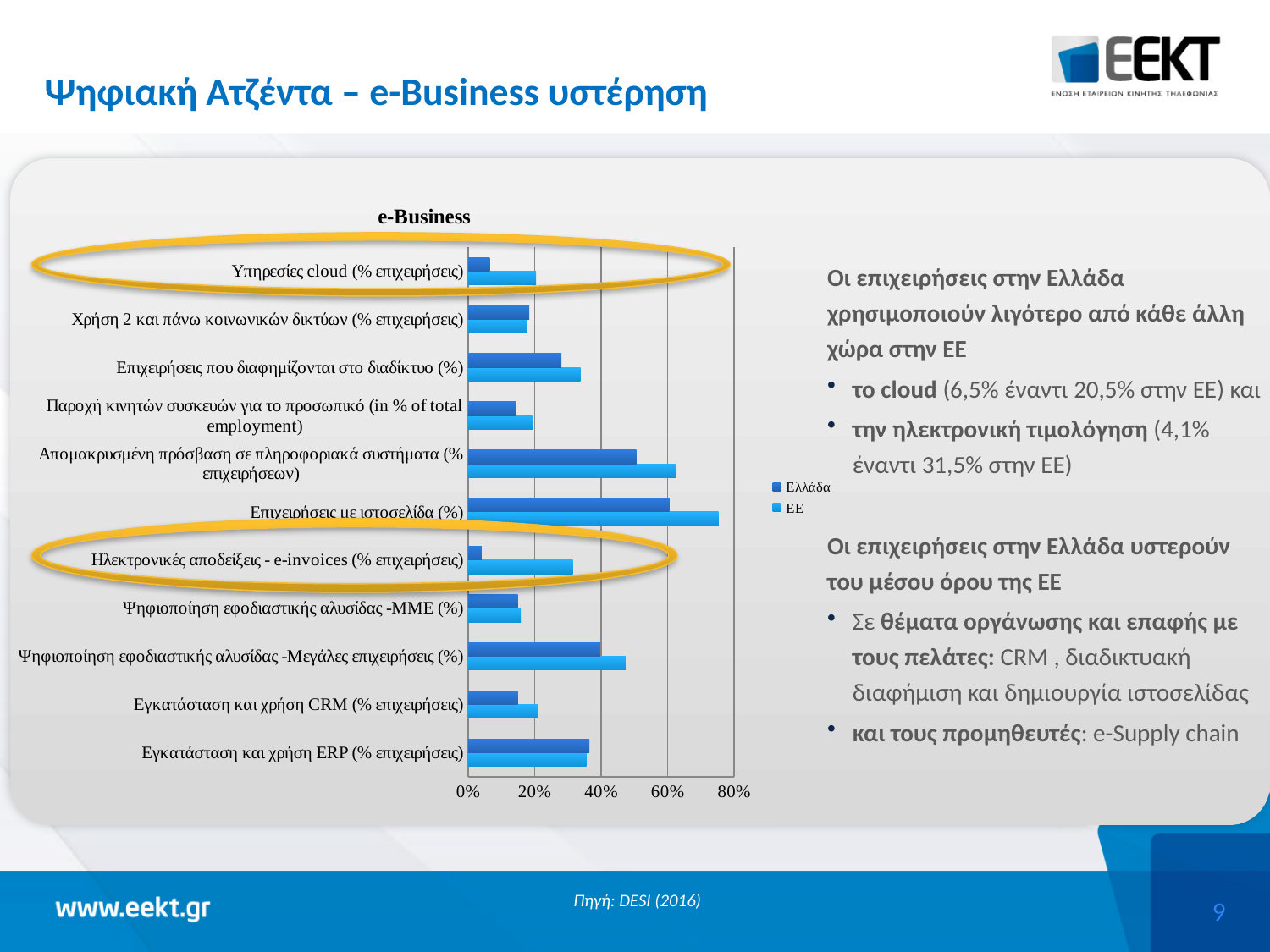
Which two series are listed in the chart legend? Ελλάδα and ΕΕ For Υπηρεσίες cloud (% επιχειρήσεις), which series has the larger value, Ελλάδα or ΕΕ? ΕΕ Is the Ελλάδα value for Απομακρυσμένη πρόσβαση σε πληροφοριακά συστήματα (% επιχειρήσεων) greater or less than 40%? greater Which category has the highest value for the ΕΕ series? Επιχειρήσεις με ιστοσελίδα (%) Which category has the highest value for the Ελλάδα series? Επιχειρήσεις με ιστοσελίδα (%) For Ηλεκτρονικές αποδείξεις - e-invoices (% επιχειρήσεις), which series has the larger value, Ελλάδα or ΕΕ? ΕΕ What is the title of the chart? e-Business Is the ΕΕ value for Επιχειρήσεις με ιστοσελίδα (%) greater or less than 60%? greater What kind of chart is shown on the slide? bar chart Is the Ελλάδα value for Ηλεκτρονικές αποδείξεις - e-invoices (% επιχειρήσεις) greater or less than 20%? less How many categories are plotted on the chart? 11 How many series does the chart legend list? 2